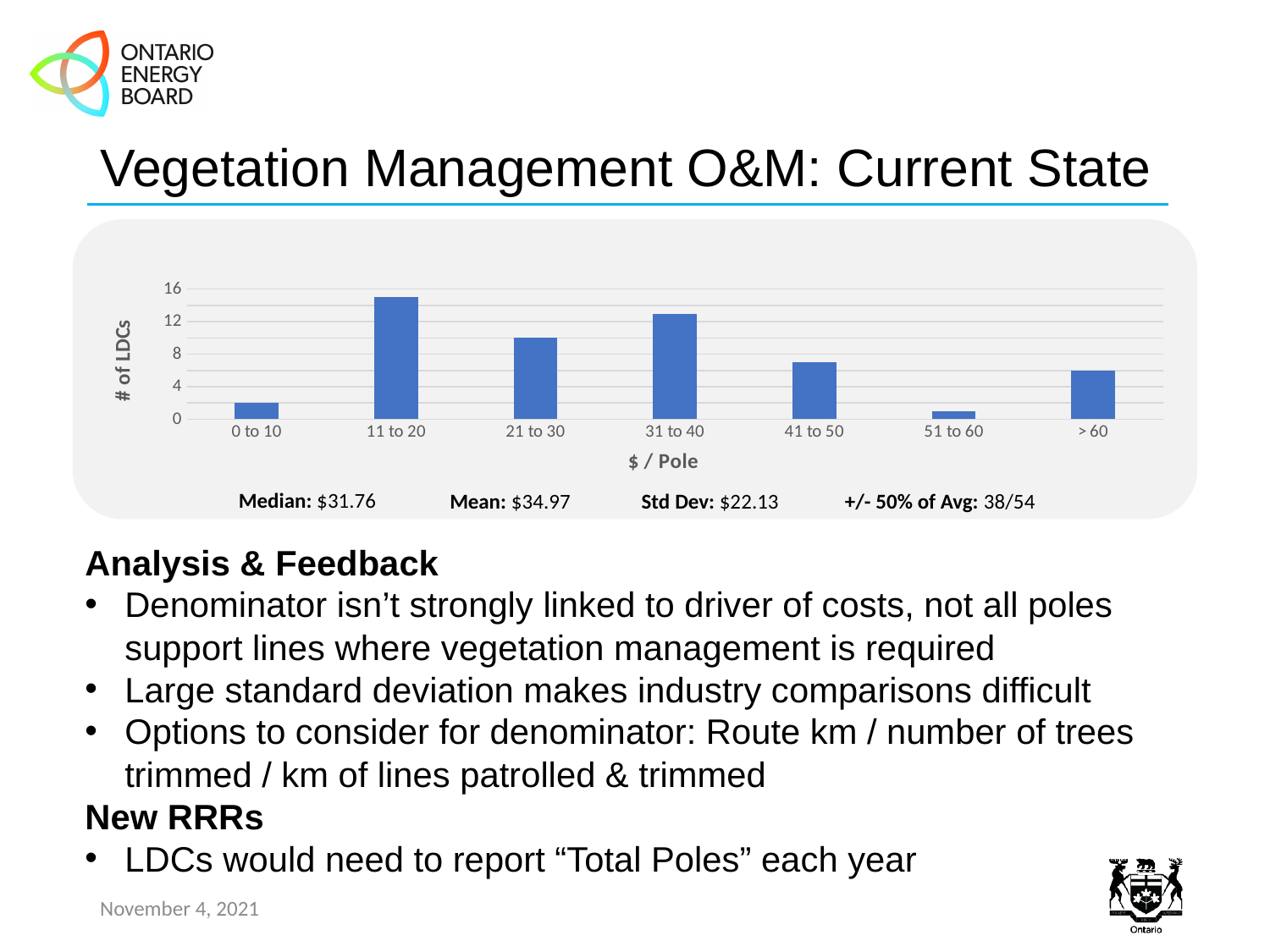
Is the number of LDCs for the > 60 category greater or less than 4? greater What is the title of the x axis of the chart? $ / Pole Which category has more LDCs, 21 to 30 or 41 to 50? 21 to 30 What is the title of the y axis of the chart? # of LDCs Is the number of LDCs for the 31 to 40 category greater or less than 12? greater Which $ / Pole category has the highest number of LDCs? 11 to 20 Which $ / Pole category has the lowest number of LDCs? 51 to 60 How many $ / Pole categories are shown on the x axis of the chart? 7 What kind of chart is shown on the slide? bar chart Is the number of LDCs for the 0 to 10 category greater or less than 4? less